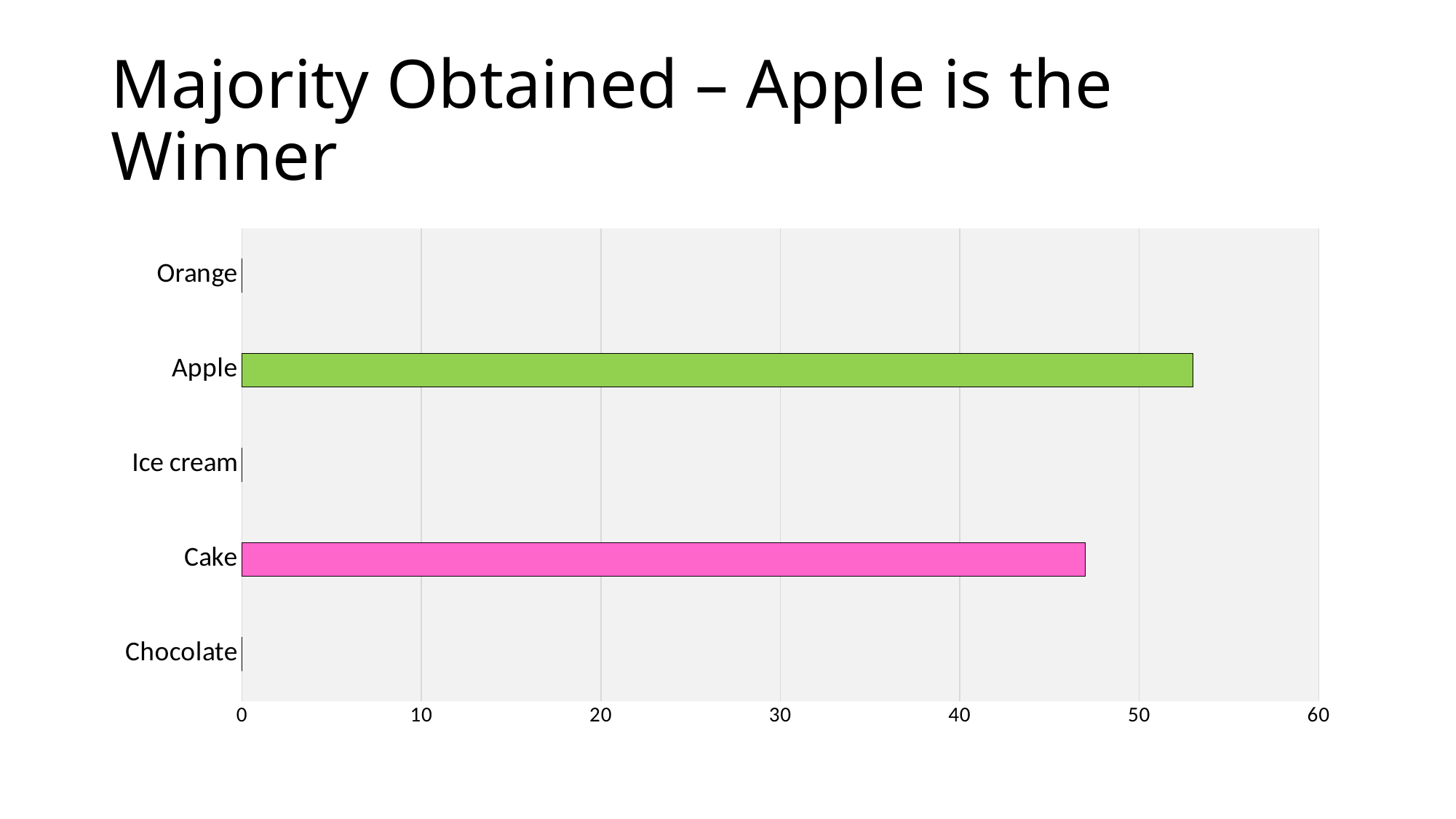
What is the title of the slide? Majority Obtained – Apple is the Winner What kind of chart is shown on the slide? bar chart Is the value for Cake greater or less than 50? less Is the value for Apple greater or less than 60? less What is the highest value shown on the horizontal axis of the chart? 60 Is the value for Cake greater or less than 40? greater How many categories are listed on the vertical axis of the chart? 5 Which is larger, the value for Apple or the value for Cake? Apple Which category has the highest value in the chart? Apple Which categories in the chart show no visible bar? Orange, Ice cream, Chocolate